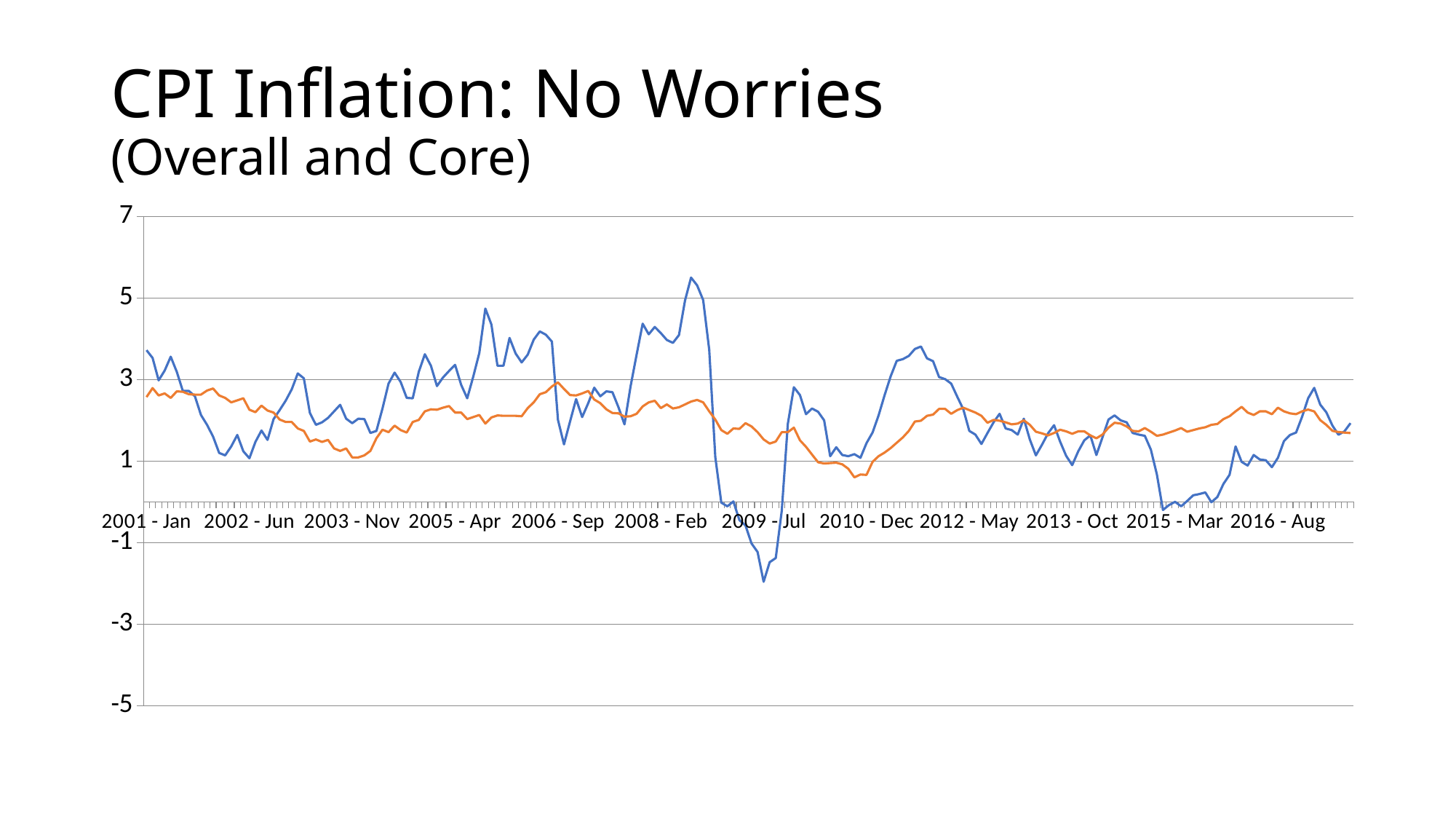
Does the blue line rise or fall between 2008 - Feb and 2009 - Jul? fall Which line reaches the lower minimum value, the blue line or the orange line? blue line Is the peak of the blue line around 2008 greater or less than 5? greater What is the title of the chart on the slide? CPI Inflation: No Worries (Overall and Core) What is the highest value shown on the y axis? 7 What kind of chart is shown on the slide? line chart Is the value of the blue line at 2001 - Jan greater or less than 3? greater Is the lowest point of the blue line, reached between 2009 - Jul and 2010 - Dec, greater or less than -1? less Which line reaches the higher peak value, the blue line or the orange line? blue line How many lines (series) are plotted on the chart? 2 How many date labels are shown along the x axis? 12